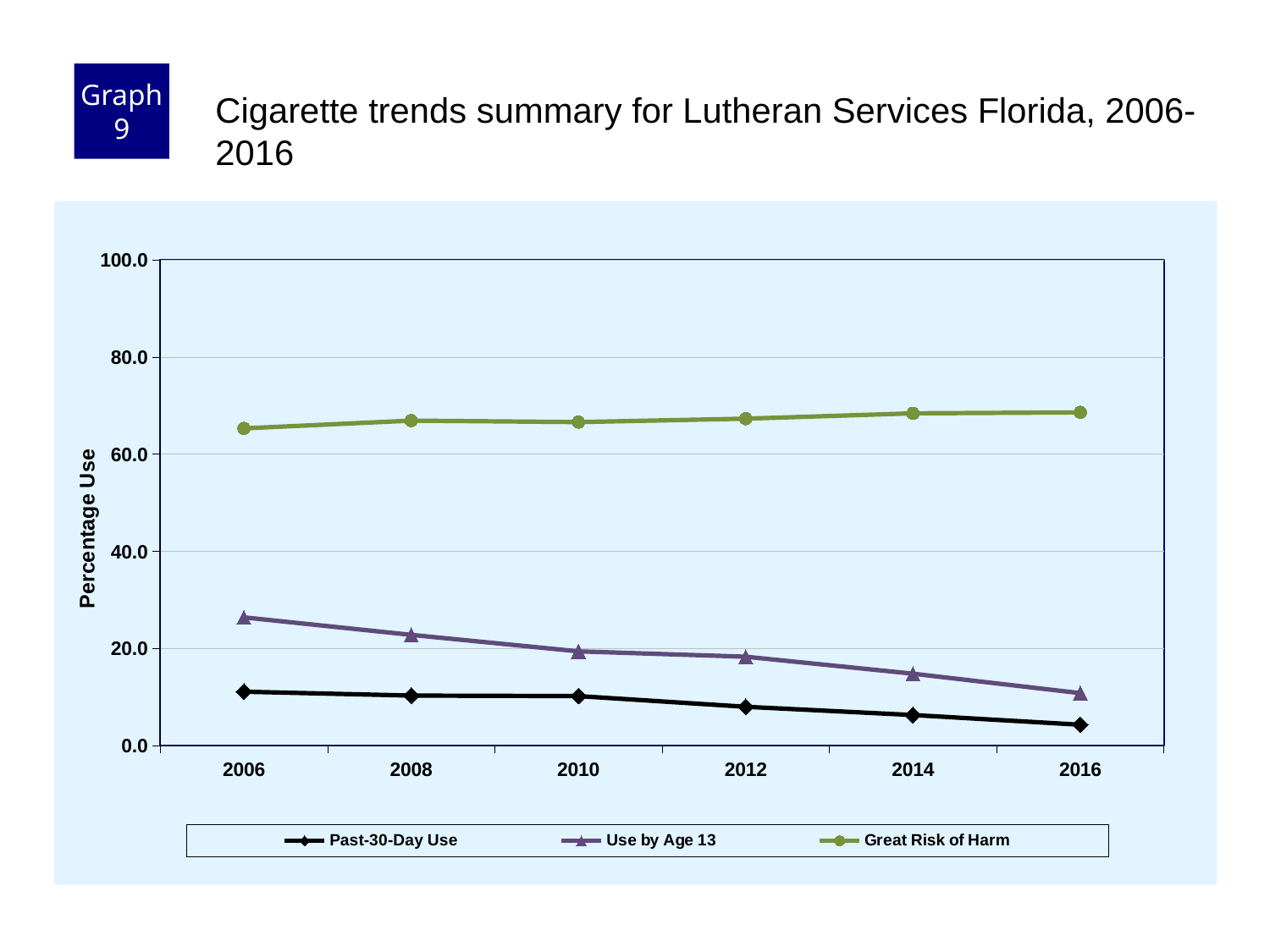
In which year is the Past-30-Day Use series lowest? 2016 Does the Use by Age 13 series rise or fall from 2006 to 2016? fall Does the Past-30-Day Use series rise or fall from 2006 to 2016? fall Is the value for Past-30-Day Use in 2016 greater or less than 20? less Is the value for Use by Age 13 in 2006 greater or less than 20? greater How many series does the legend list? 3 In which year is the Use by Age 13 series highest? 2006 Is the value for Use by Age 13 in 2016 greater or less than 20? less In 2010, which is larger: Use by Age 13 or Past-30-Day Use? Use by Age 13 What kind of chart is shown on the slide? line chart How many years are plotted along the x axis? 6